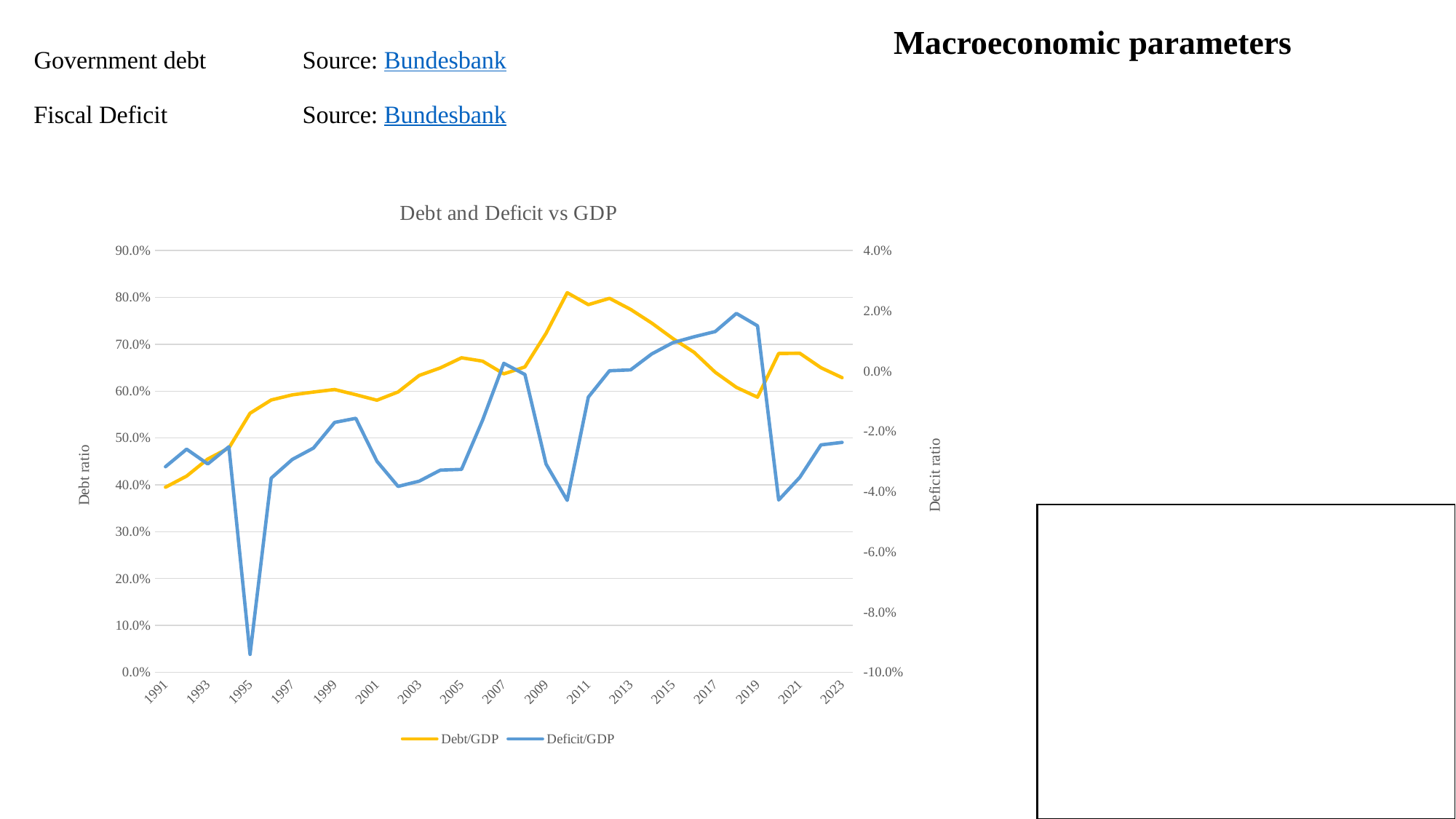
Does the Debt/GDP series rise or fall between 1991 and 2010? Rise Is the Deficit/GDP value for 1995 less or greater than -8.0%? less Is the Deficit/GDP value for 2020 greater or less than -2.0%? less In which year is the Deficit/GDP series at its lowest in the "Debt and Deficit vs GDP" chart? 1995 What are the two series named in the legend of the "Debt and Deficit vs GDP" chart? Debt/GDP and Deficit/GDP In which year is the Debt/GDP series at its lowest in the "Debt and Deficit vs GDP" chart? 1991 What is the label of the right-hand vertical axis in the "Debt and Deficit vs GDP" chart? Deficit ratio What kind of chart is "Debt and Deficit vs GDP"? Line chart Is the Debt/GDP value for 2023 greater or less than 60.0%? greater Which year has the higher Debt/GDP value, 2019 or 2021? 2021 How many series does the legend of the "Debt and Deficit vs GDP" chart list? 2